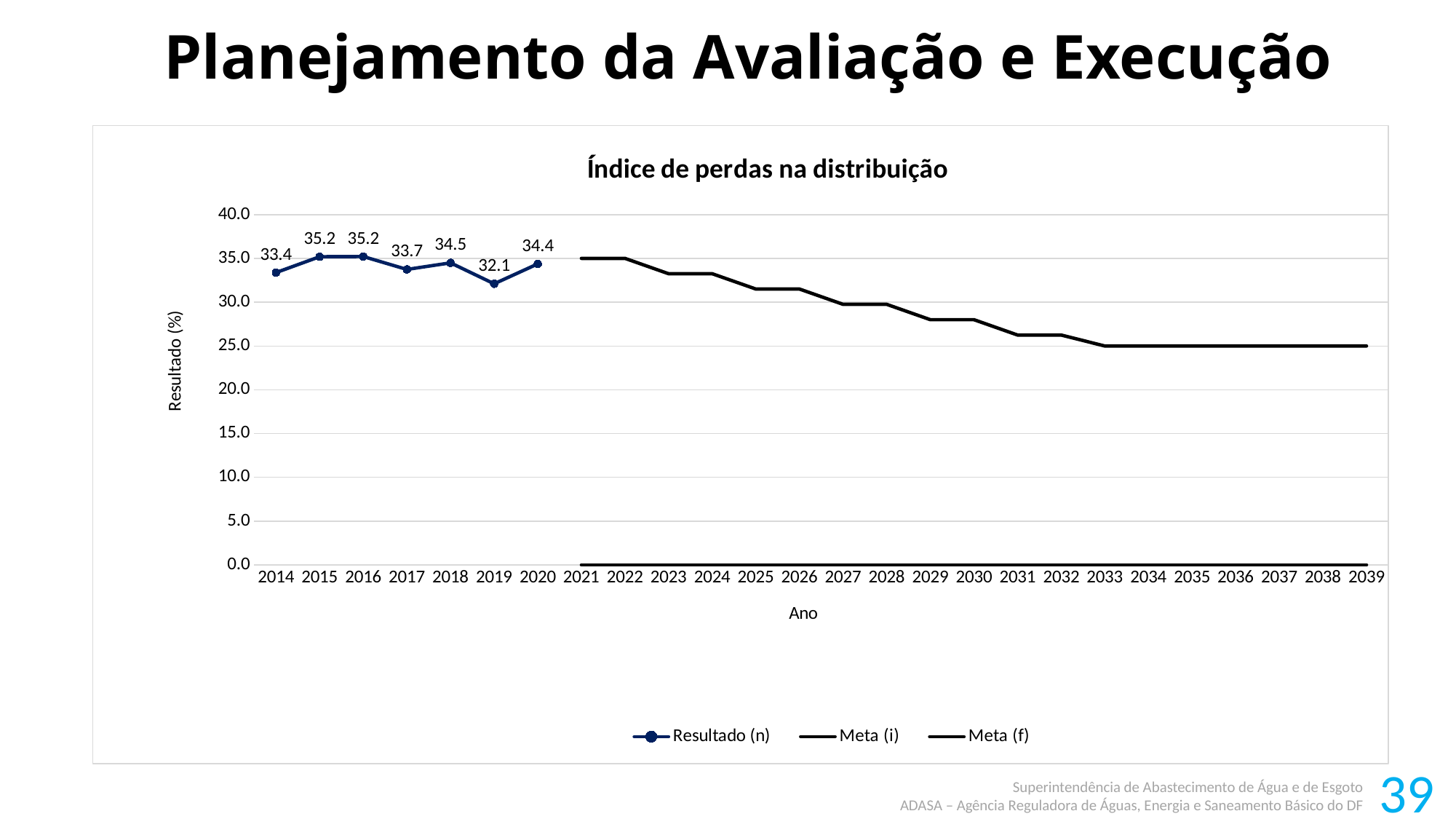
How many series does the legend list? 3 What is the value of Resultado (n) for 2019? 32.1 Is the Meta (i) value for 2039 greater or less than 30.0? less Which year has the larger Resultado (n) value, 2017 or 2018? 2018 What is the difference between the Resultado (n) values for 2020 and 2019? 2.3 What is the value of Resultado (n) for 2014? 33.4 In which year is the Resultado (n) value lowest? 2019 What is the value of Resultado (n) for 2020? 34.4 What kind of chart is shown? line chart How many years are shown on the x axis? 26